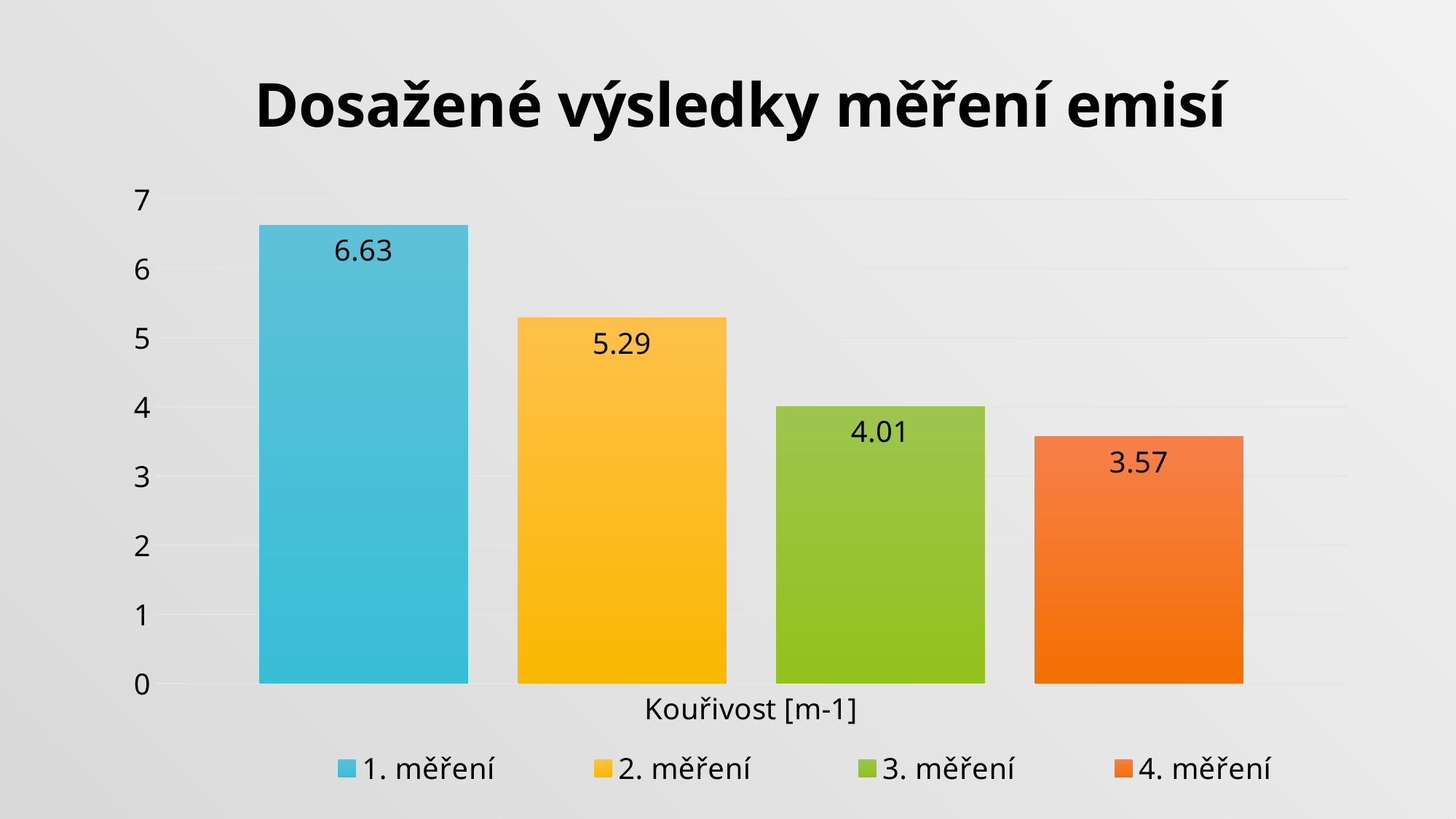
Which is larger, the value for 2. měření or the value for 3. měření? 2. měření Which series has the highest value? 1. měření What kind of chart is shown on the slide? bar chart Is the value for 2. měření greater or less than 5? greater How many series does the legend list? 4 Which series has the lowest value? 4. měření What is the value for 3. měření? 4.01 What is the value for 1. měření? 6.63 What is the title of the chart? Dosažené výsledky měření emisí What is the difference between the values for 3. měření and 4. měření? 0.44 What is the value for 4. měření? 3.57 What is the difference between the values for 1. měření and 2. měření? 1.34